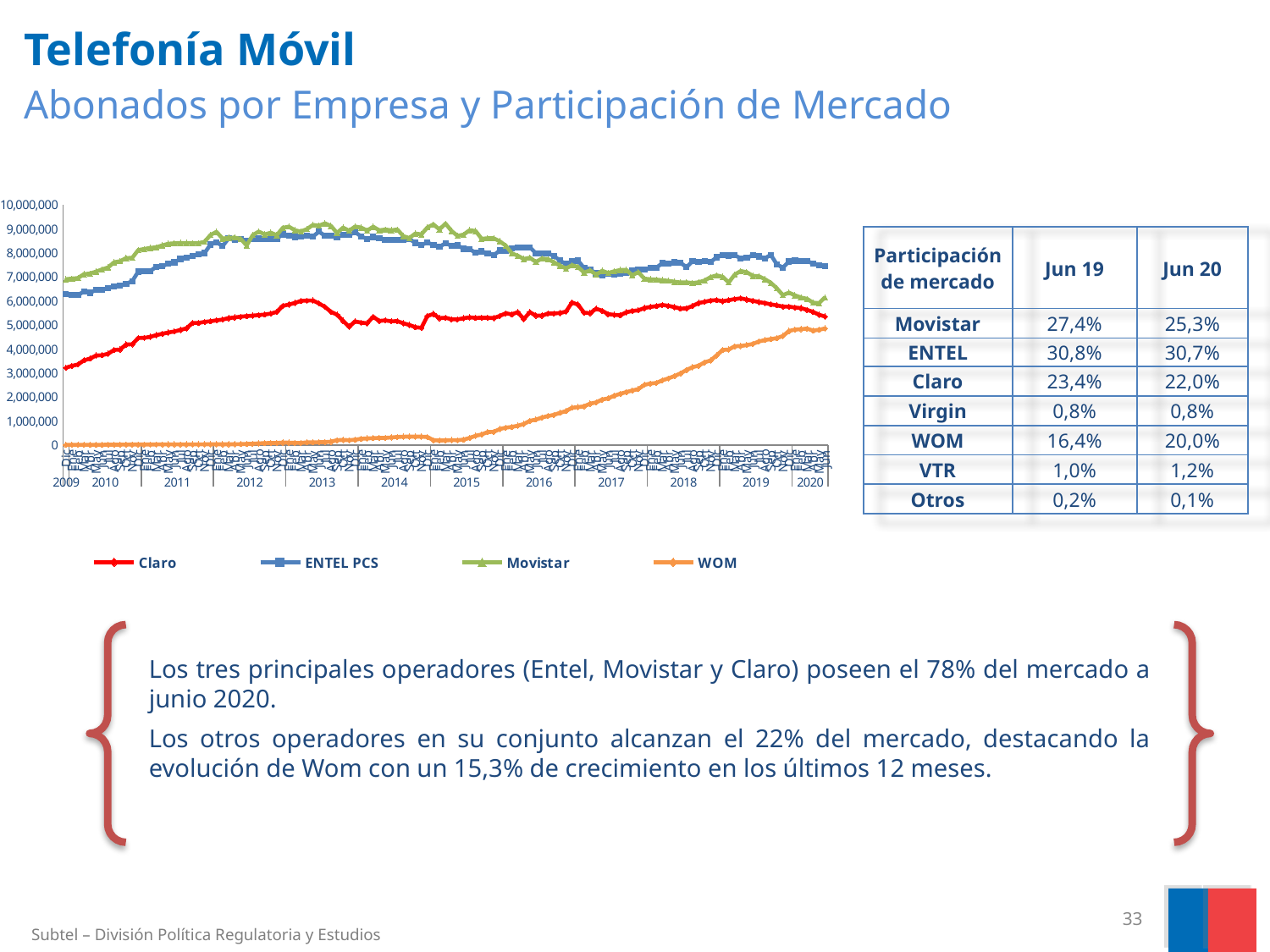
Is the value for WOM in 2015 greater or less than 1,000,000? less Which series has the highest value at the start of the chart in 2009? Movistar Does the WOM line rise or fall from 2015 to 2020? rise Which series is drawn in red in the chart? Claro Which series has the lowest values at the start of the chart in 2009? WOM What kind of chart is shown on the slide? line chart Which series is drawn in orange in the chart? WOM In 2012, which series has the larger value, Movistar or Claro? Movistar Which series has the highest value at the end of the chart in 2020? ENTEL PCS Does the Movistar line rise or fall from 2013 to 2020? fall Is the value for ENTEL PCS at the end of 2020 greater or less than 7,000,000? greater How many series does the chart legend list? 4